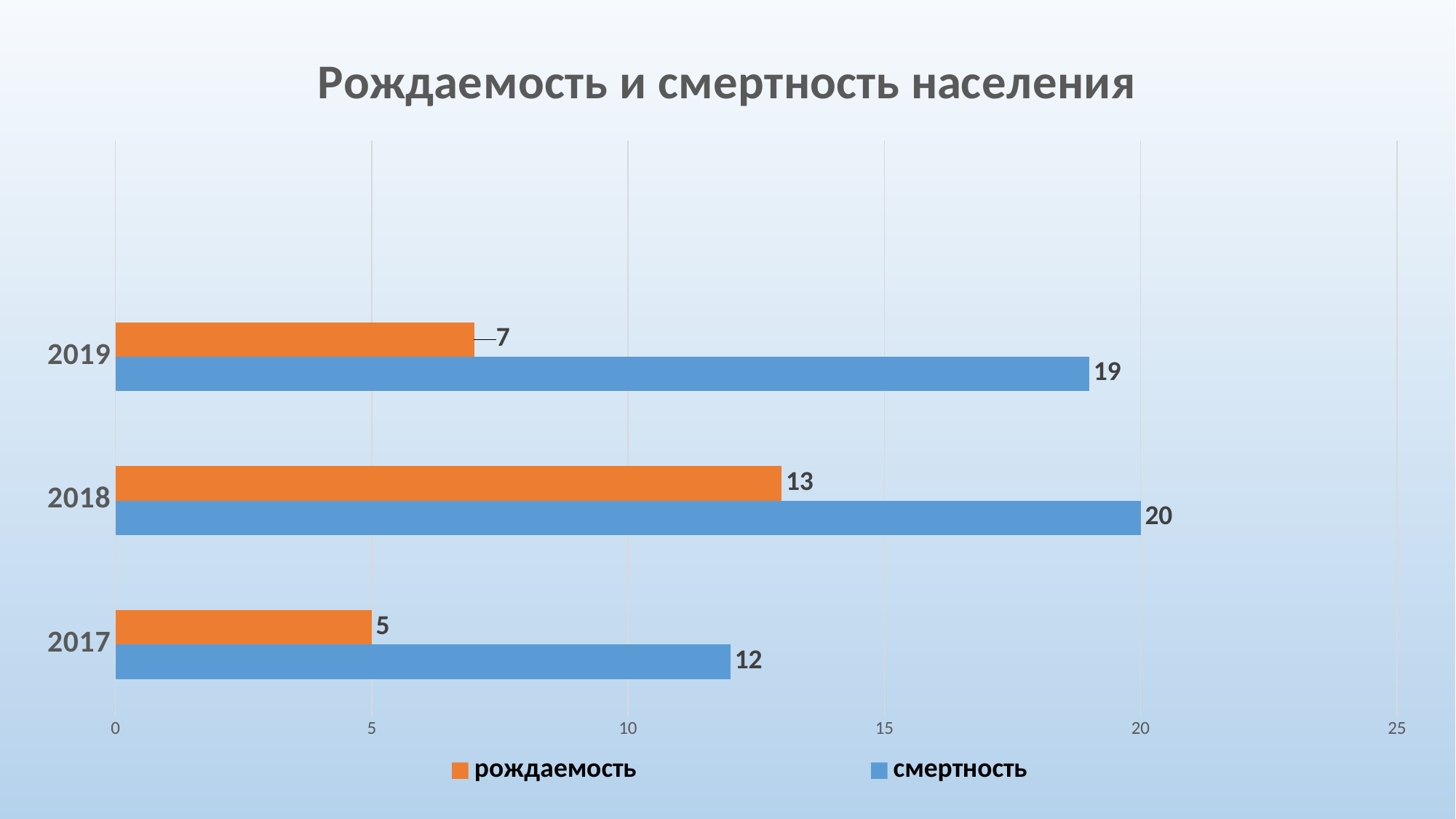
How many years are shown on the chart? 3 In which year is смертность highest? 2018 What is the value for смертность in 2018? 20 In which year is рождаемость lowest? 2017 How many series does the legend list? 2 What kind of chart is shown? bar chart What is the value for рождаемость in 2017? 5 Which is larger in 2018: рождаемость or смертность? смертность What is the value for рождаемость in 2019? 7 What is the title of the chart? Рождаемость и смертность населения What is the difference between смертность and рождаемость in 2019? 12 What is the value for смертность in 2017? 12